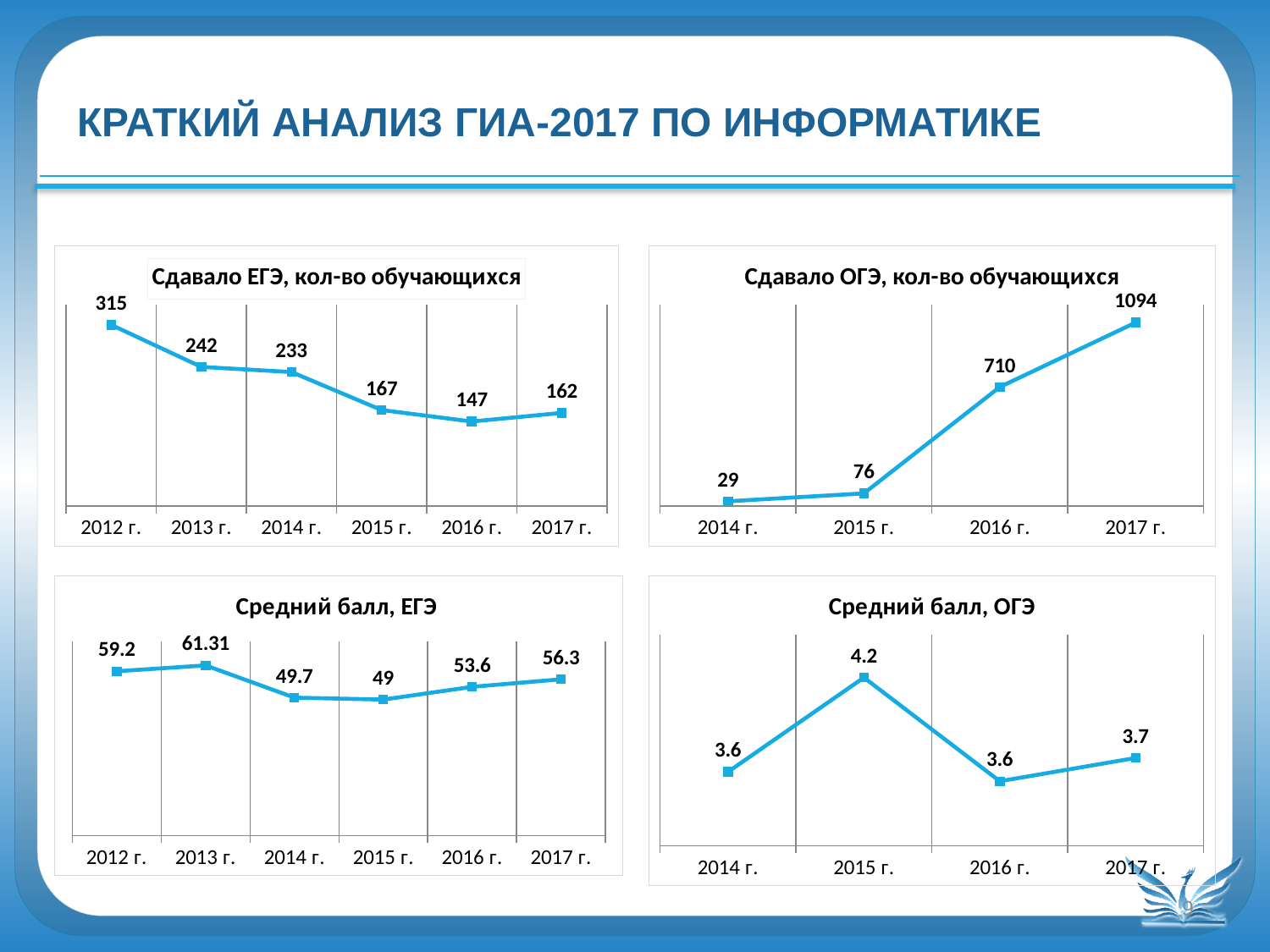
In the chart titled "Сдавало ОГЭ, кол-во обучающихся", what is the value for 2016 г.? 710 In the chart titled "Сдавало ЕГЭ, кол-во обучающихся", what is the value for 2015 г.? 167 In the chart titled "Сдавало ЕГЭ, кол-во обучающихся", what is the difference between the values for 2012 г. and 2017 г.? 153 In the chart titled "Сдавало ОГЭ, кол-во обучающихся", which year has the lowest value? 2014 г. In the chart titled "Сдавало ОГЭ, кол-во обучающихся", how many years are plotted? 4 In the chart titled "Средний балл, ЕГЭ", which is larger, the value for 2016 г. or the value for 2017 г.? 2017 г. In the chart titled "Средний балл, ЕГЭ", which year has the lowest value? 2015 г. In the chart titled "Средний балл, ОГЭ", what is the value for 2015 г.? 4.2 In the chart titled "Средний балл, ЕГЭ", what is the value for 2013 г.? 61.31 In the chart titled "Сдавало ОГЭ, кол-во обучающихся", do the values rise or fall from 2014 г. to 2017 г.? rise In the chart titled "Сдавало ЕГЭ, кол-во обучающихся", which year has the highest value? 2012 г. What type of chart is the chart titled "Средний балл, ОГЭ"? line chart